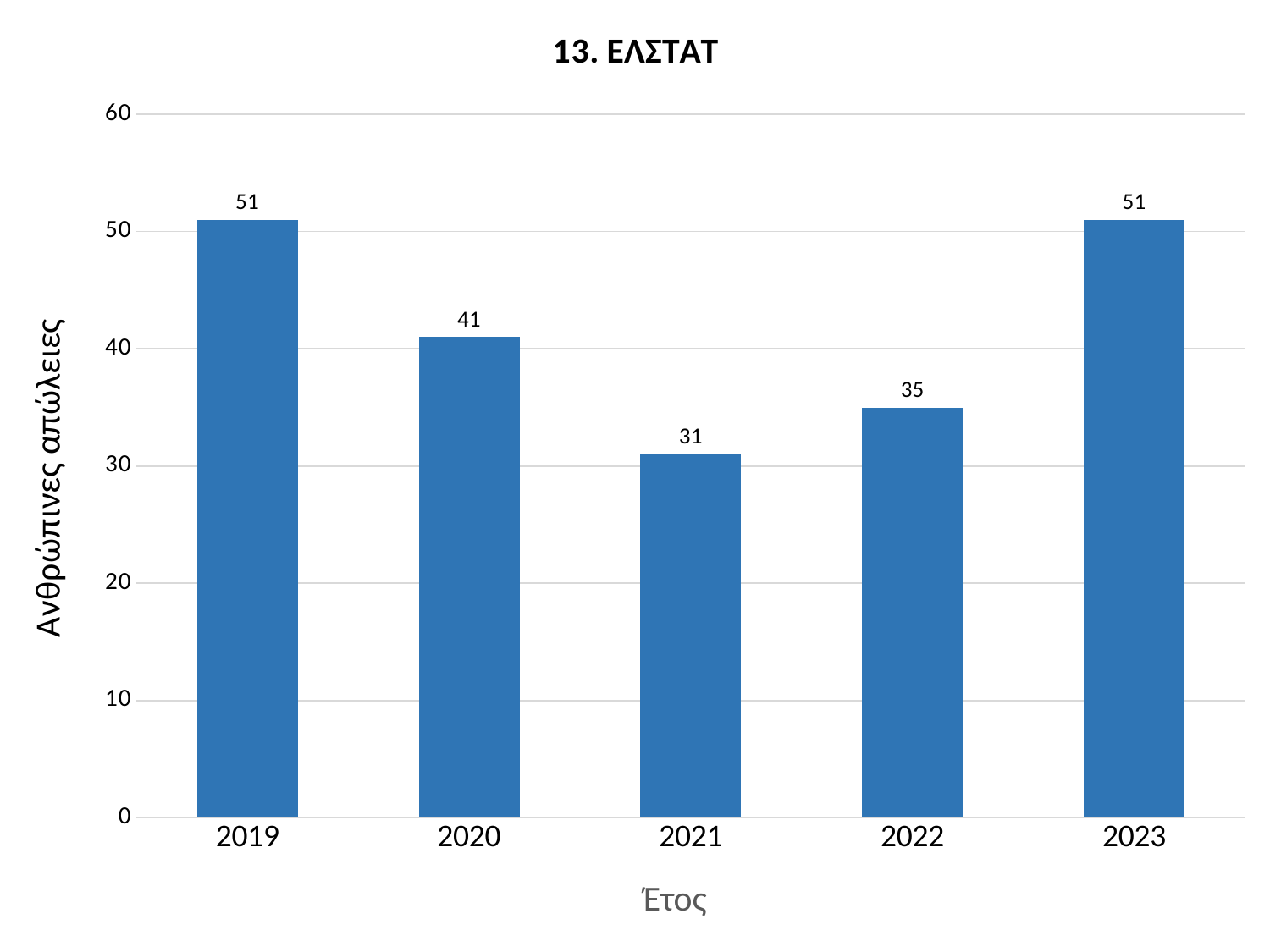
What is the difference between the values for 2020 and 2022? 6 How many years are shown on the x axis? 5 What kind of chart is this? bar chart Do the values rise or fall from 2019 to 2021? fall What is the value for 2019? 51 What is the title of the chart? 13. ΕΛΣΤΑΤ Which year has the lowest value? 2021 What is the value for 2021? 31 Which is larger, the value for 2020 or the value for 2022? 2020 What is the value for 2022? 35 What is the difference between the values for 2019 and 2021? 20 Is the value for 2023 greater or less than 40? greater